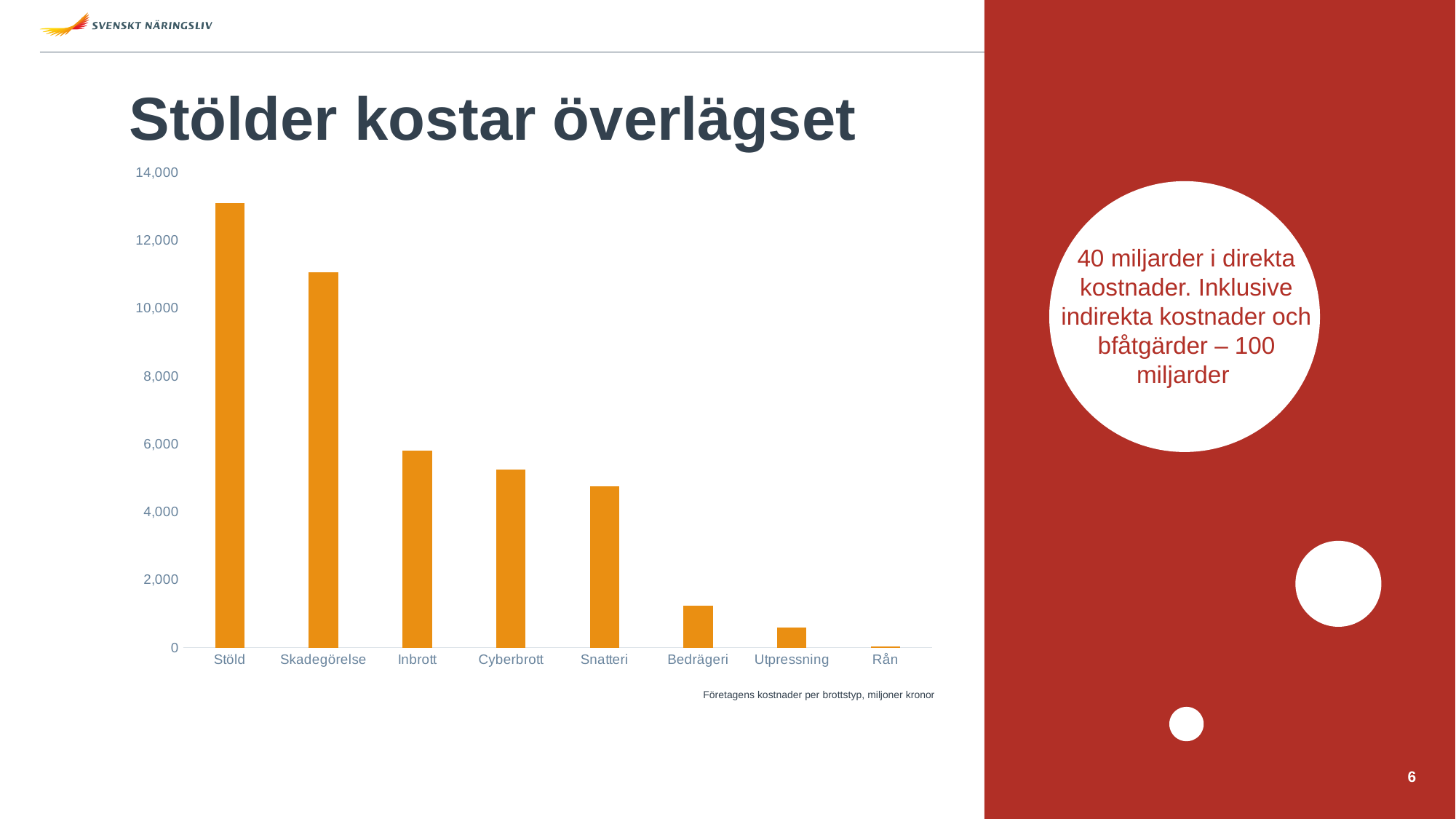
What kind of chart is shown on the slide? bar chart Is the value for Inbrott greater or less than 6,000? less What is the title of the slide containing the chart? Stölder kostar överlägset Is the value for Stöld greater or less than 12,000? greater Which is larger, the value for Inbrott or the value for Cyberbrott? Inbrott Is the value for Snatteri greater or less than 4,000? greater Which category has the highest value in the chart? Stöld Do the values rise or fall moving from left to right along the x axis? fall How many categories (crime types) are shown on the x axis of the chart? 8 Which category has the lowest value in the chart? Rån